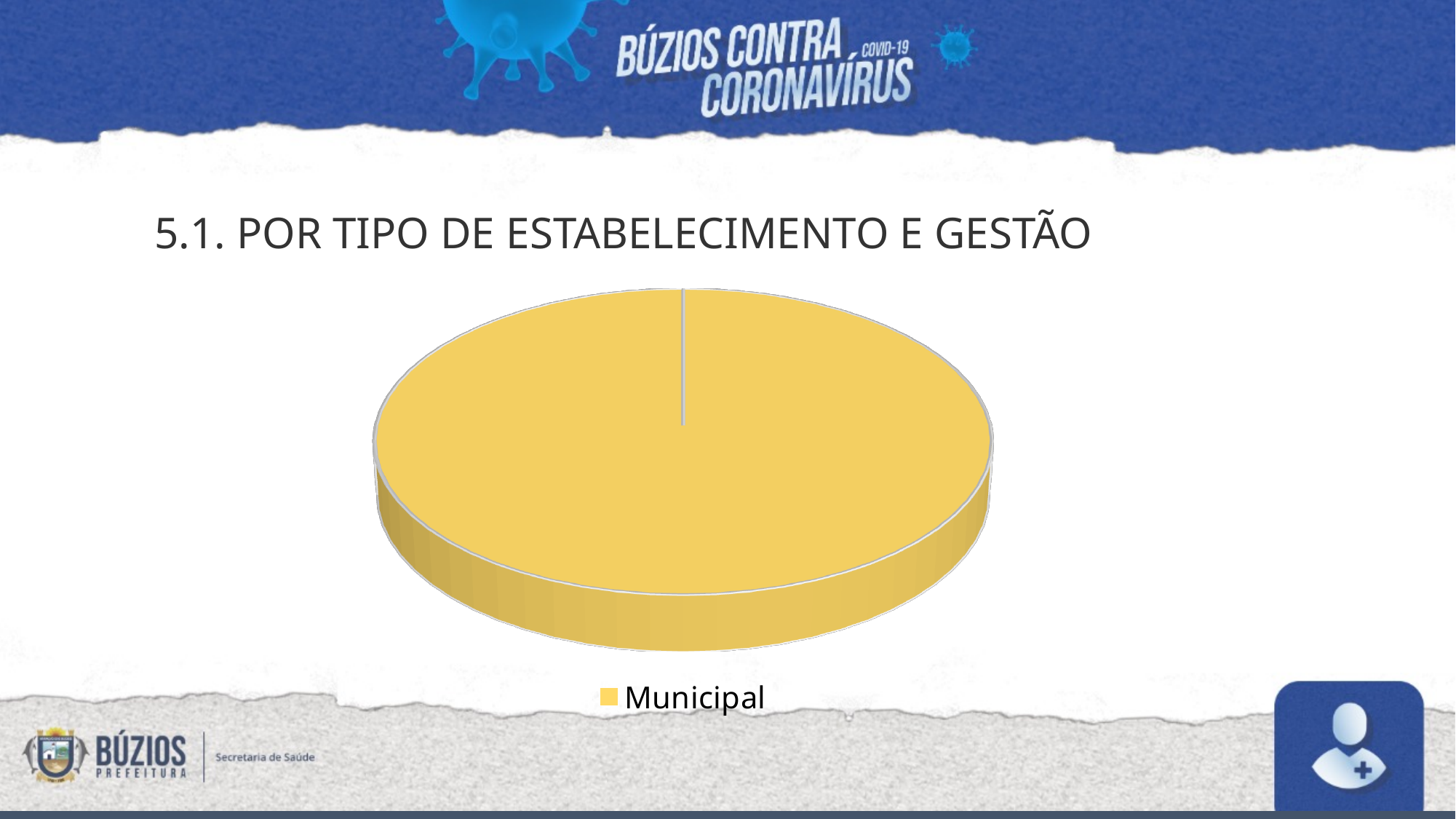
How many slices does the pie chart have? 1 What is the title of the chart section on the slide? 5.1. POR TIPO DE ESTABELECIMENTO E GESTÃO What is the name of the only category shown in the pie chart's legend? Municipal What share of the pie does the Municipal slice take up? 100% How many entries does the chart's legend list? 1 What kind of chart is shown on the slide? pie chart